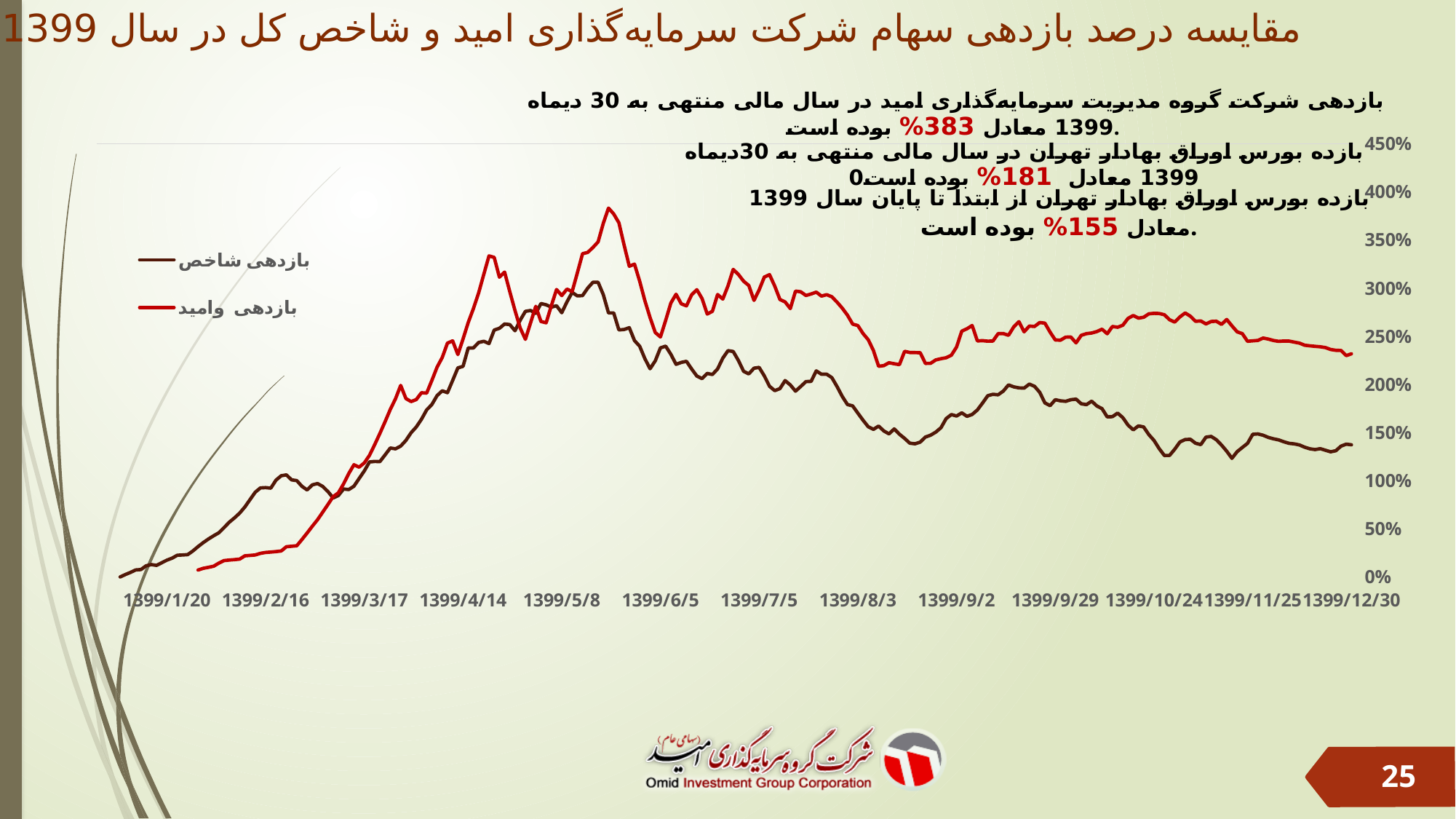
Between 1399/1/20 and 1399/5/8, does the بازدهی وامید line generally rise or fall? rise At 1399/12/30, is the value of بازدهی شاخص greater or less than 200%? less How many series does the chart's legend list? 2 How many date labels are shown on the x axis? 13 At 1399/2/16, which series has the higher value, بازدهی شاخص or بازدهی وامید? بازدهی شاخص At 1399/12/30, is the value of بازدهی وامید greater or less than 200%? greater What kind of chart is shown on the slide? line chart Is the highest point reached by بازدهی وامید greater or less than 350%? greater Which colour is used for the بازدهی وامید series? red What are the two series named in the chart's legend? بازدهی شاخص and بازدهی وامید At 1399/12/30, which series has the higher value, بازدهی شاخص or بازدهی وامید? بازدهی وامید